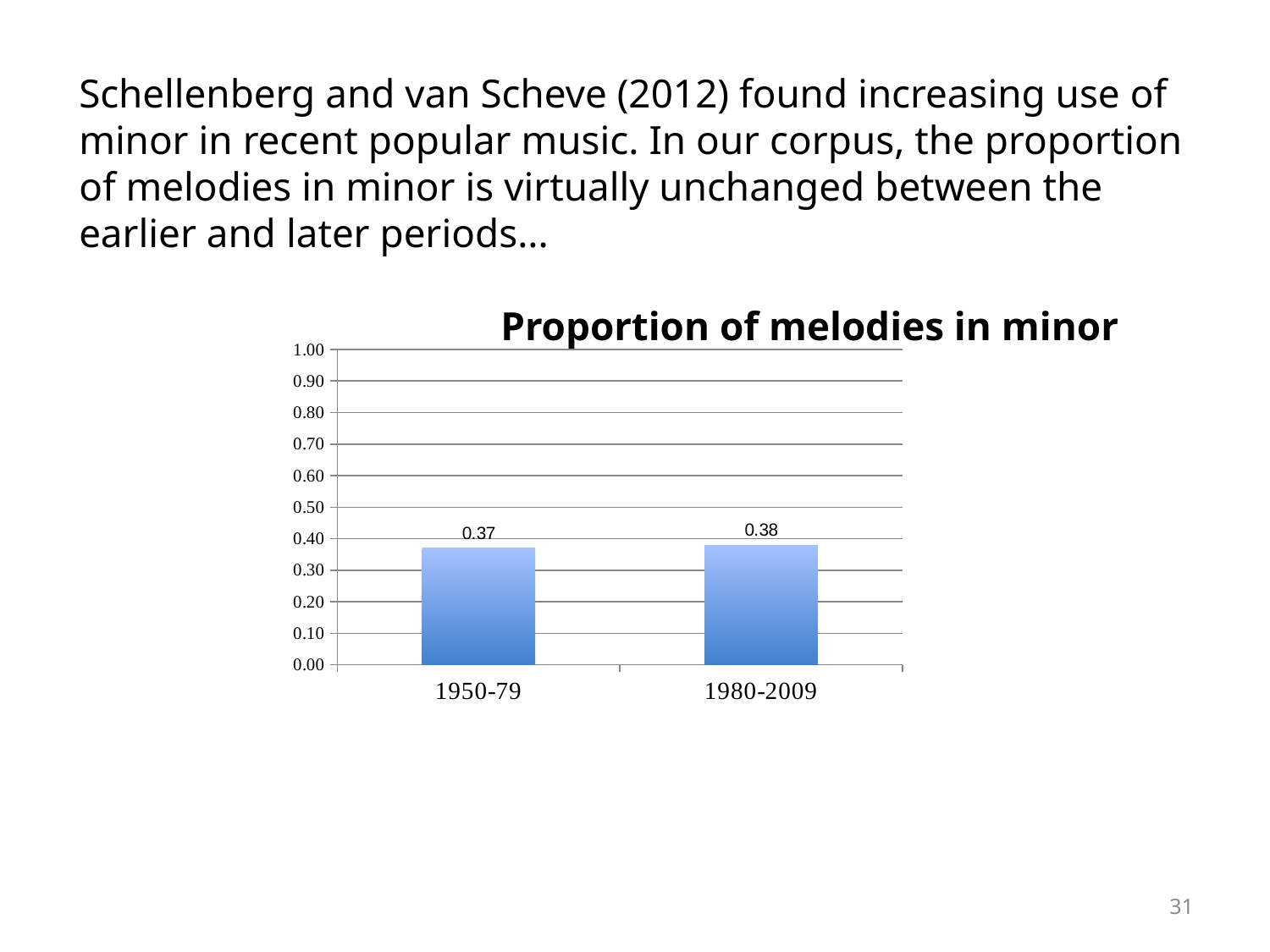
What is the proportion of melodies in minor for 1950-79? 0.37 Is the proportion of melodies in minor for 1950-79 greater or less than 0.50? less What is the difference between the proportion of melodies in minor for 1980-2009 and for 1950-79? 0.01 Do the values rise or fall from 1950-79 to 1980-2009? rise What is the maximum value shown on the chart's vertical axis? 1.00 Is the proportion of melodies in minor for 1980-2009 greater or less than 0.30? greater Which period has the higher proportion of melodies in minor? 1980-2009 What is the title of the chart? Proportion of melodies in minor What is the proportion of melodies in minor for 1980-2009? 0.38 What kind of chart is shown on the slide? bar chart How many periods are shown on the chart? 2 Which period has the lower proportion of melodies in minor? 1950-79